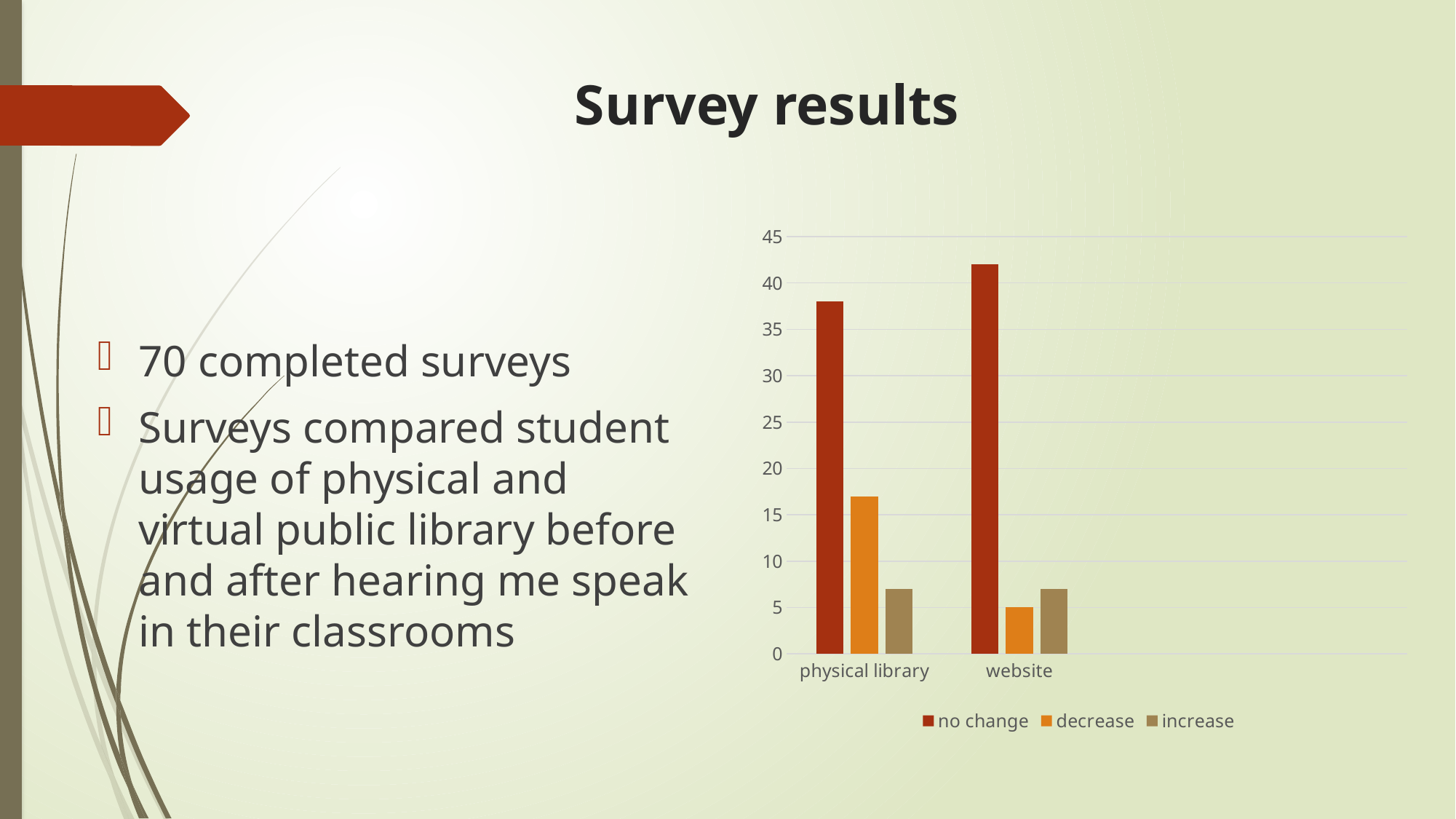
Which category has the larger 'no change' value, physical library or website? website What kind of chart is shown on the slide? bar chart Is the 'increase' value for physical library greater or less than 10? less How many categories are shown on the x axis of the chart? 2 Which series has the shortest bar for the physical library category? increase Is the 'decrease' value for website greater or less than 10? less Is the 'decrease' value for physical library greater or less than 15? greater Which series has the tallest bar for the website category? no change How many series does the chart's legend list? 3 Which category has the larger 'decrease' value, physical library or website? physical library